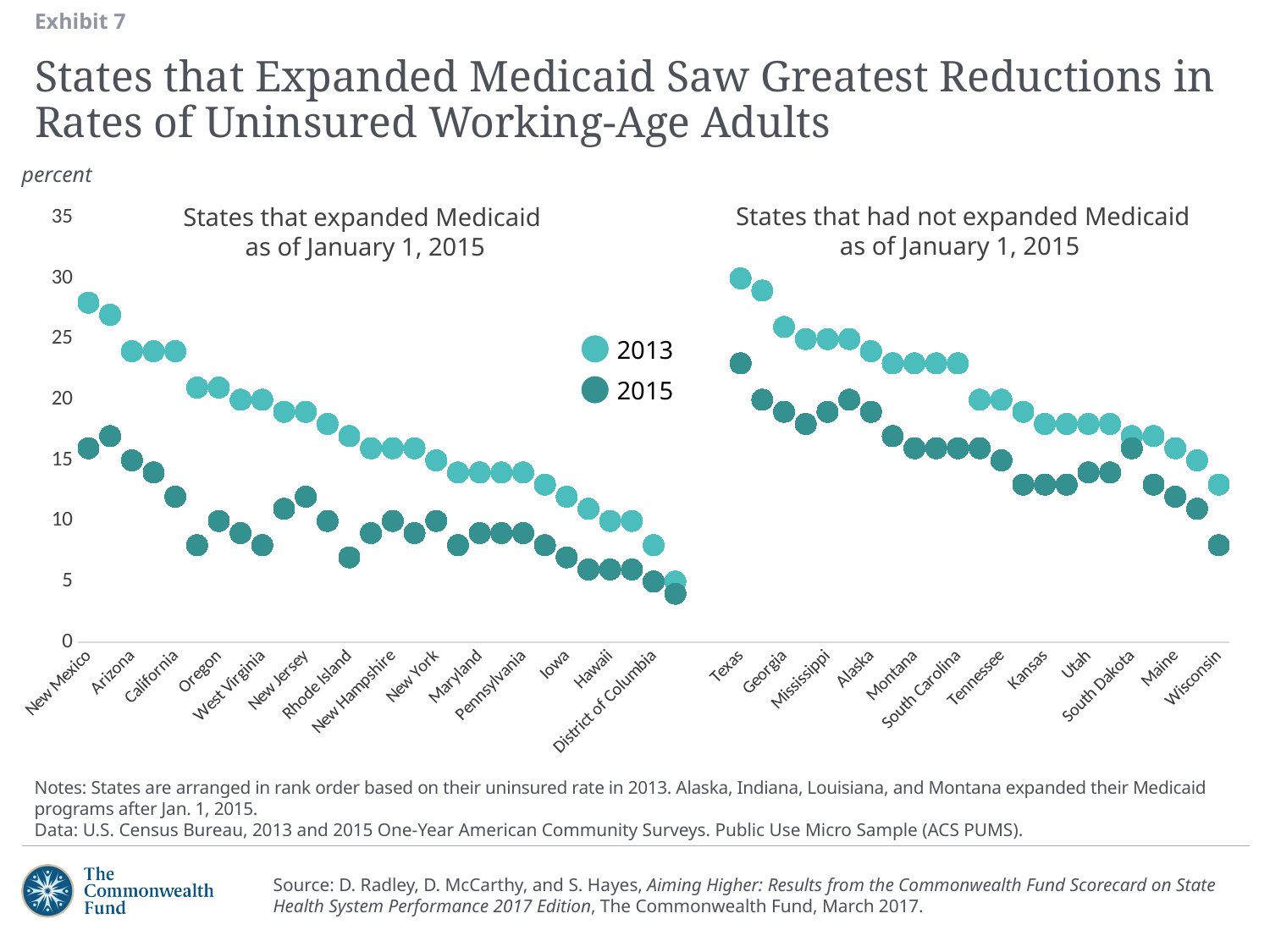
Which two years are shown in the legend? 2013 and 2015 In the 'States that expanded Medicaid' panel, is the 2013 value for New Mexico greater or less than 25? greater In the 'States that had not expanded Medicaid' panel, is the 2015 value for Wisconsin greater or less than 10? less In the 'States that had not expanded Medicaid' panel, which state has the highest 2013 uninsured rate? Texas In the 'States that expanded Medicaid' panel, is the 2015 value for New Mexico greater or less than 20? less In the 'States that expanded Medicaid' panel, which state has the highest 2013 uninsured rate? New Mexico In the 'States that expanded Medicaid' panel, do the 2013 values rise or fall from left to right? fall What kind of chart is shown on the slide? Scatter (dot) chart How many series does the legend list? 2